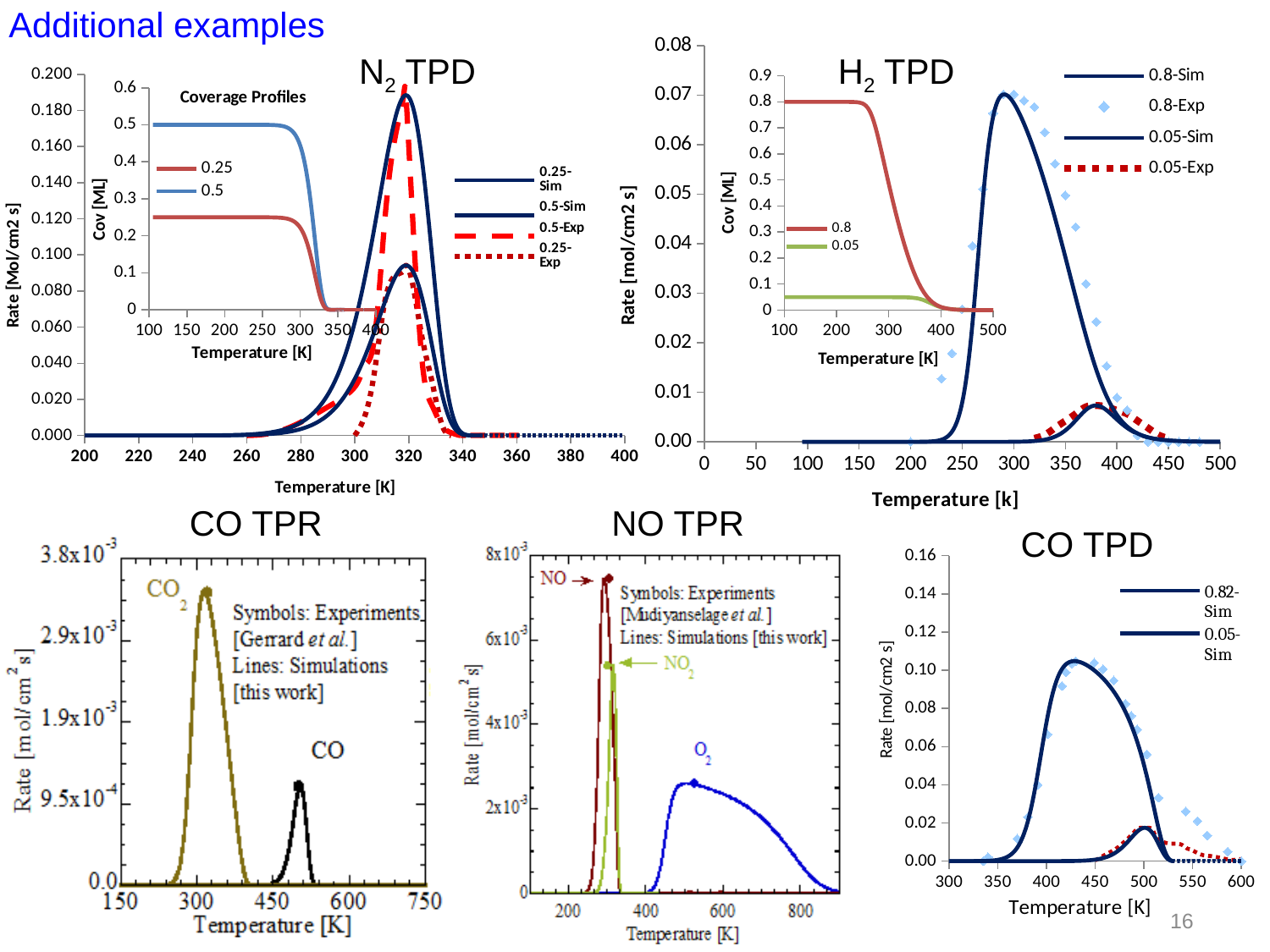
In the H₂ TPD chart, is the peak value of the 0.8-Sim curve greater or less than 0.06? greater How many series does the legend of the H₂ TPD chart list? 4 In the CO TPR chart, which species has the higher peak rate, CO₂ or CO? CO₂ In the N₂ TPD chart, which curve reaches a higher peak, 0.5-Sim or 0.25-Sim? 0.5-Sim In the H₂ TPD chart, is the peak value of the 0.05-Sim curve greater or less than 0.02? less How many series does the legend of the N₂ TPD chart list? 4 What kind of chart is the N₂ TPD chart? line chart In the NO TPR chart, which species has the highest peak rate? NO In the N₂ TPD chart, is the peak value of the 0.5-Sim curve greater or less than 0.160? greater In the NO TPR chart, which species has the lowest peak rate? O₂ How many series does the legend of the CO TPD chart list? 2